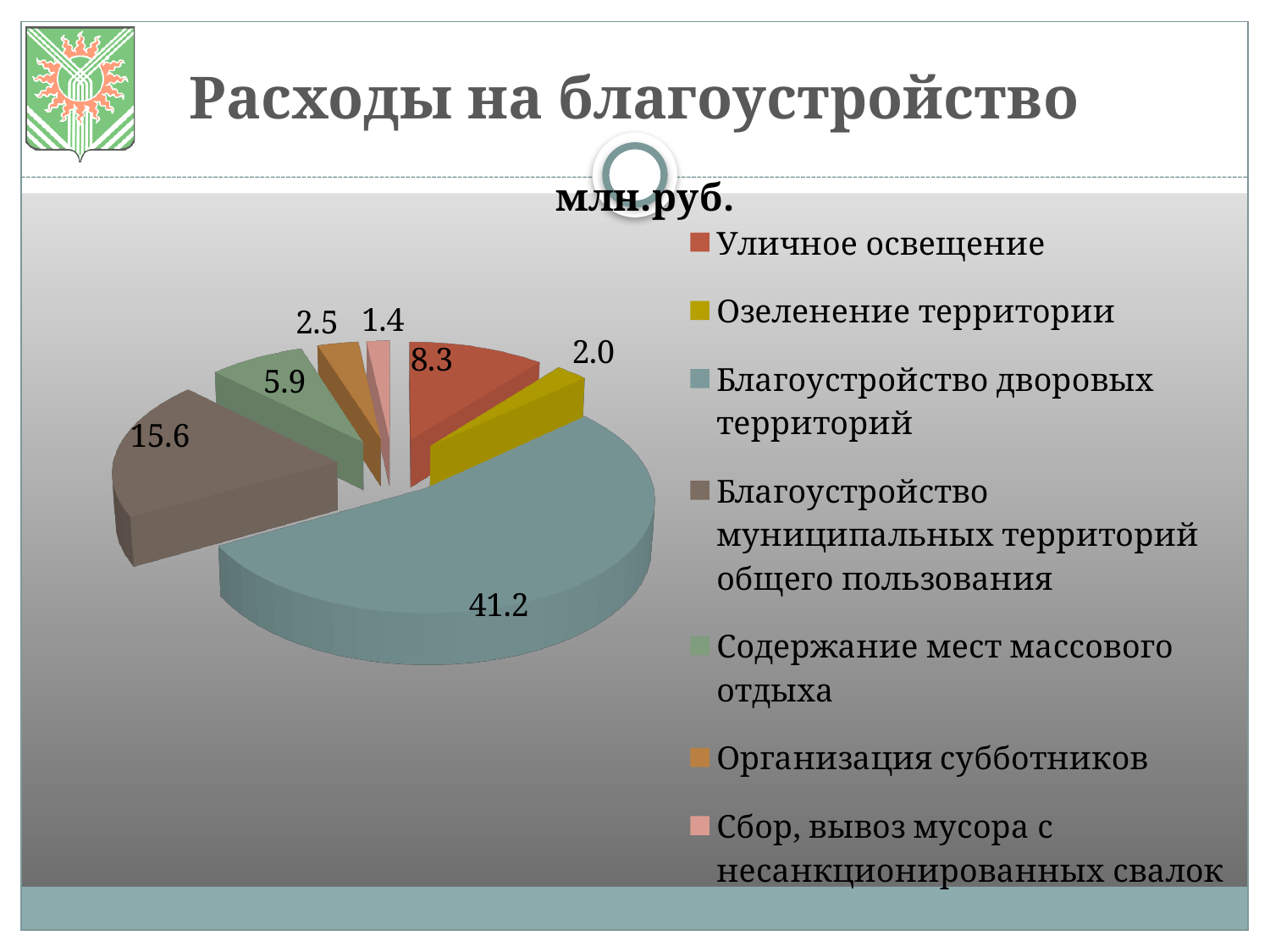
What is the value for Благоустройство дворовых территорий? 41.2 What kind of chart is shown on the slide? Pie chart Which is larger, the value for Организация субботников or the value for Озеленение территории? Организация субботников What is the difference between the values for Благоустройство дворовых территорий and Благоустройство муниципальных территорий общего пользования? 25.6 What is the value for Содержание мест массового отдыха? 5.9 Which category has the smallest slice of the pie? Сбор, вывоз мусора с несанкционированных свалок What unit is given in the chart title? млн.руб. Which category has the largest slice of the pie? Благоустройство дворовых территорий What is the value for Благоустройство муниципальных территорий общего пользования? 15.6 How many categories does the legend list? 7 What is the value for Сбор, вывоз мусора с несанкционированных свалок? 1.4 What is the value for Уличное освещение? 8.3